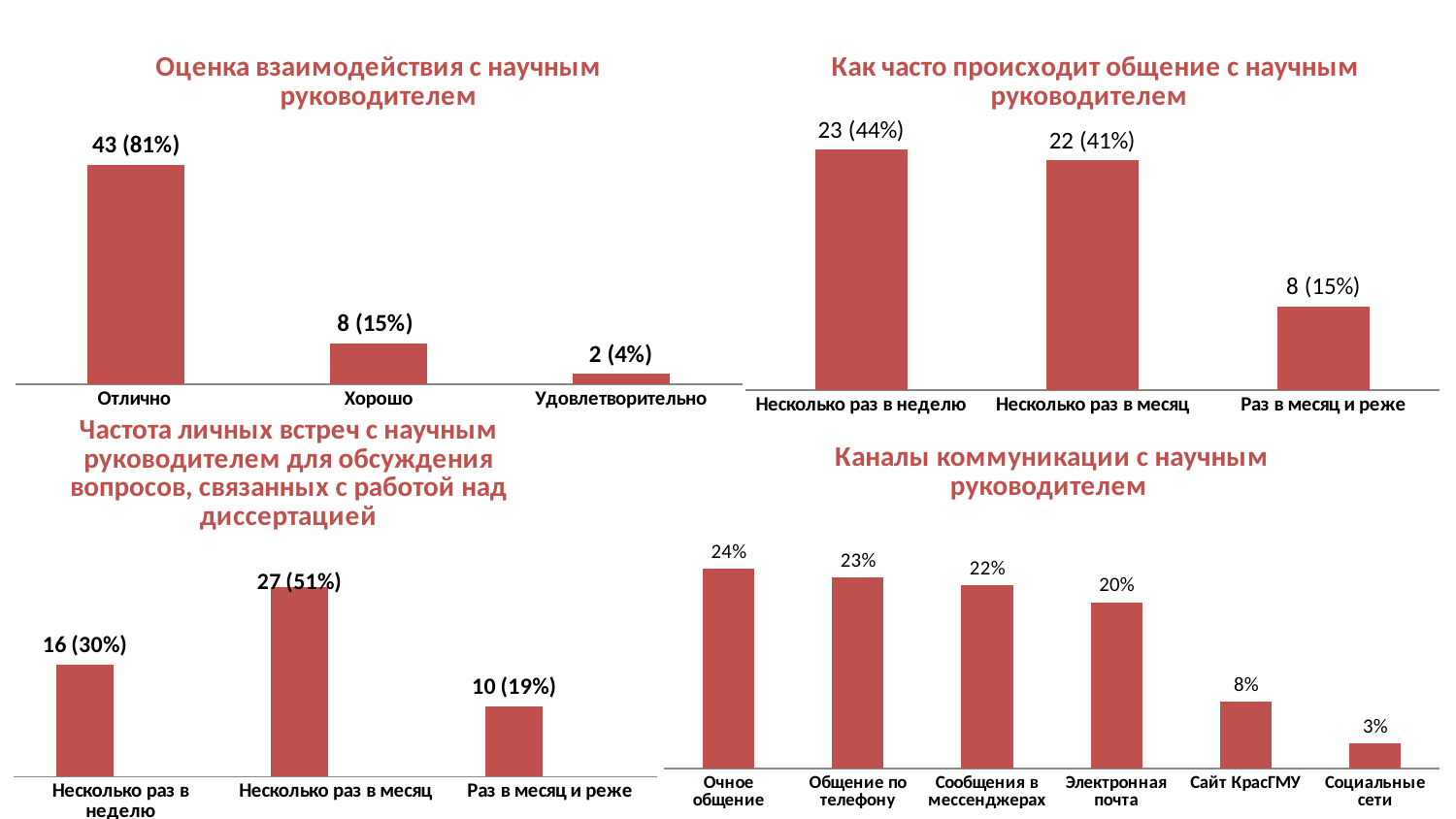
In the bottom-right chart 'Каналы коммуникации с научным руководителем', which category has the lowest value? Социальные сети In the bottom-left chart 'Частота личных встреч с научным руководителем', which is larger: 'Несколько раз в неделю' or 'Раз в месяц и реже'? Несколько раз в неделю In the top-left chart 'Оценка взаимодействия с научным руководителем', how many categories are shown? 3 In the bottom-right chart 'Каналы коммуникации с научным руководителем', how many categories are shown? 6 In the top-left chart 'Оценка взаимодействия с научным руководителем', what is the value for 'Отлично'? 43 (81%) In the top-right chart 'Как часто происходит общение с научным руководителем', what is the difference in count between 'Несколько раз в неделю' and 'Раз в месяц и реже'? 15 In the top-right chart 'Как часто происходит общение с научным руководителем', what is the value for 'Раз в месяц и реже'? 8 (15%) In the top-left chart 'Оценка взаимодействия с научным руководителем', which category has the lowest value? Удовлетворительно In the bottom-right chart 'Каналы коммуникации с научным руководителем', what is the value for 'Электронная почта'? 20% In the bottom-left chart 'Частота личных встреч с научным руководителем', what is the value for 'Несколько раз в неделю'? 16 (30%) In the bottom-left chart 'Частота личных встреч с научным руководителем', which category has the highest value? Несколько раз в месяц What type of chart is the bottom-right chart 'Каналы коммуникации с научным руководителем'? Bar chart